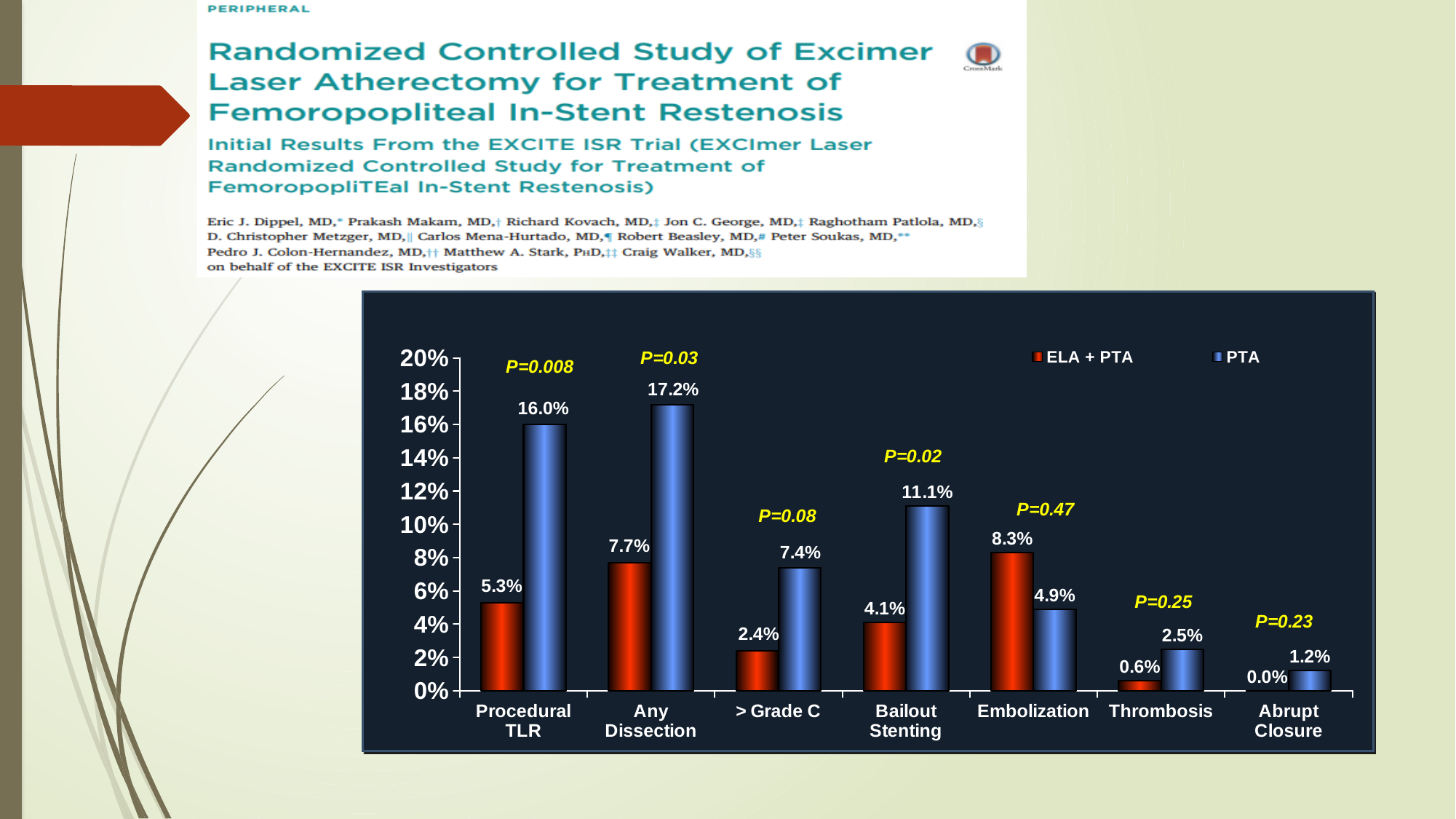
What is the difference between the PTA and ELA + PTA values for Procedural TLR? 10.7% In the Embolization category, which series has the larger value, ELA + PTA or PTA? ELA + PTA How many series does the legend list? 2 Which category has the highest PTA value? Any Dissection What is the value for PTA in the Any Dissection category? 17.2% What is the value for ELA + PTA in the Embolization category? 8.3% What is the value for ELA + PTA in the Procedural TLR category? 5.3% What is the value for PTA in the Abrupt Closure category? 1.2% How many categories are shown on the x axis? 7 What kind of chart is shown on the slide? Bar chart What P value is shown above the Bailout Stenting category? P=0.02 Which category has the lowest ELA + PTA value? Abrupt Closure